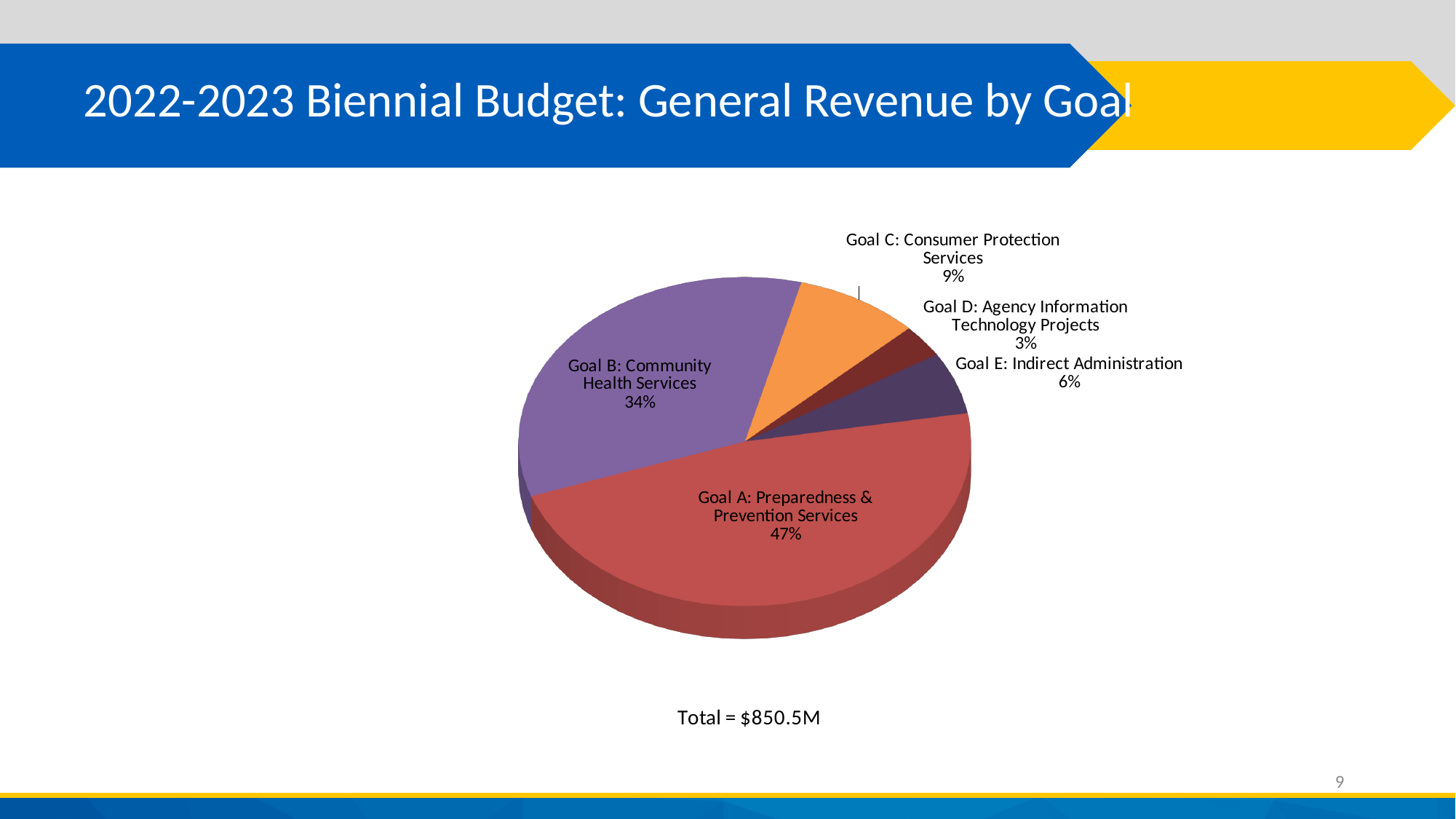
What total amount is stated below the chart? $850.5M What share of general revenue goes to Goal A: Preparedness & Prevention Services? 47% How many goals are shown in the pie chart? 5 What share of general revenue goes to Goal C: Consumer Protection Services? 9% What share of general revenue goes to Goal B: Community Health Services? 34% Which goal receives the largest share of general revenue? Goal A: Preparedness & Prevention Services Which has a larger share, Goal C: Consumer Protection Services or Goal E: Indirect Administration? Goal C: Consumer Protection Services What kind of chart is shown on the slide? Pie chart What is the difference in percentage points between Goal A and Goal B? 13 What share of general revenue goes to Goal D: Agency Information Technology Projects? 3% What share of general revenue goes to Goal E: Indirect Administration? 6% Which goal receives the smallest share of general revenue? Goal D: Agency Information Technology Projects